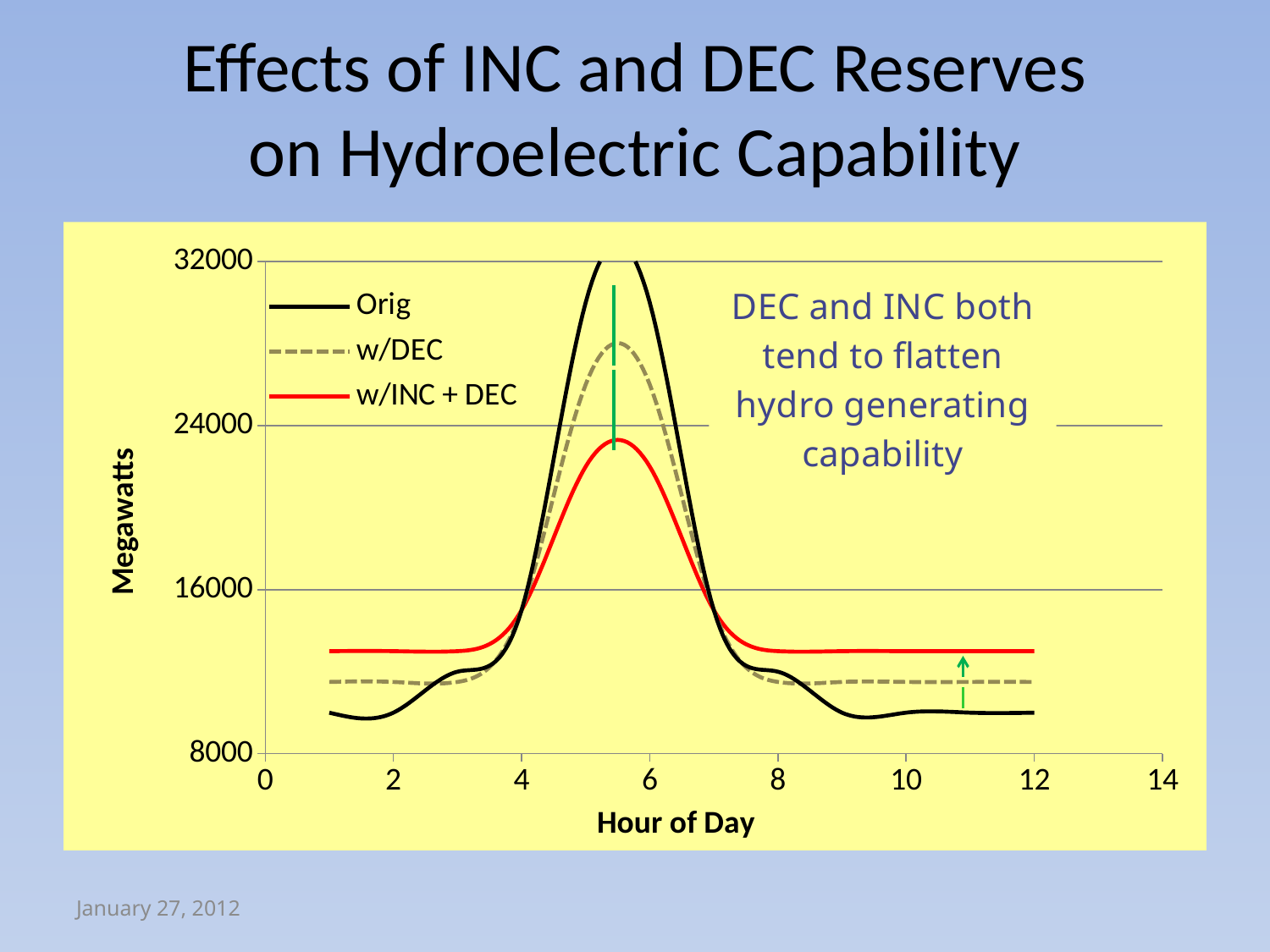
Is the peak value of the w/DEC series greater or less than 24000? greater Is the Orig value at hour 10 greater or less than 16000? less Is the peak value of the w/INC + DEC series greater or less than 24000? less What are the three series named in the chart's legend? Orig, w/DEC, w/INC + DEC How many series does the chart's legend list? 3 At hour 10, which series is higher, Orig or w/INC + DEC? w/INC + DEC Which series reaches the highest peak on the chart? Orig What kind of chart is shown on the slide? line chart What is the title of the chart's vertical axis? Megawatts Does the Orig series rise or fall between hour 6 and hour 8? fall Which series has the lowest peak on the chart? w/INC + DEC